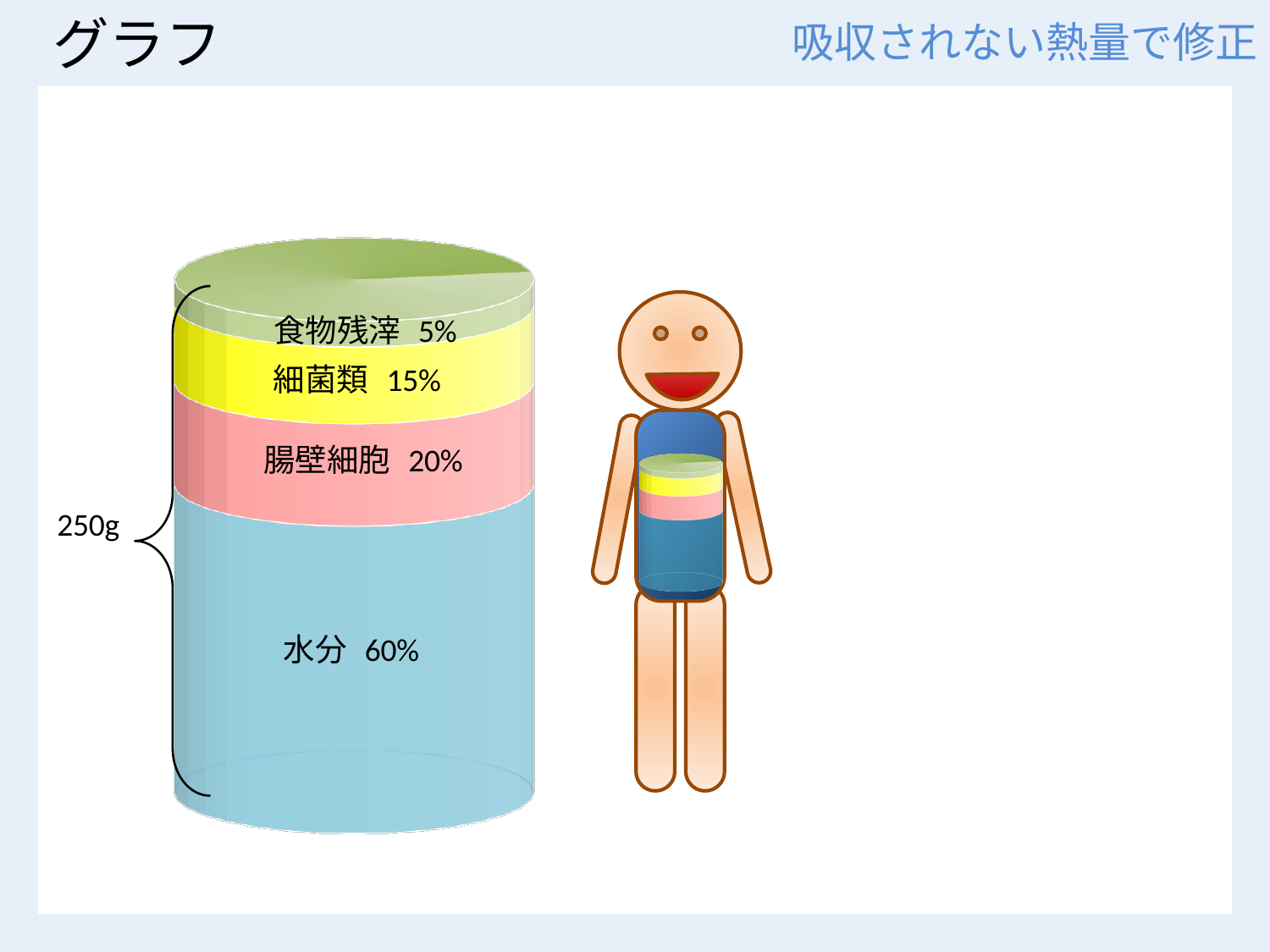
What is the difference in percentage between 水分 and 腸壁細胞? 40% What percentage is shown for 食物残滓? 5% What percentage is shown for 細菌類? 15% What total weight does the bracket next to the stacked cylinder indicate? 250g Which segment of the stacked cylinder has the largest share? 水分 How many segments make up the stacked cylinder? 4 What percentage is shown for 水分 in the stacked cylinder chart? 60% What colour is the 水分 segment of the stacked cylinder? Light blue Which has a larger share, 腸壁細胞 or 細菌類? 腸壁細胞 Which segment of the stacked cylinder has the smallest share? 食物残滓 What is the difference in percentage between 細菌類 and 食物残滓? 10% What percentage is shown for 腸壁細胞? 20%